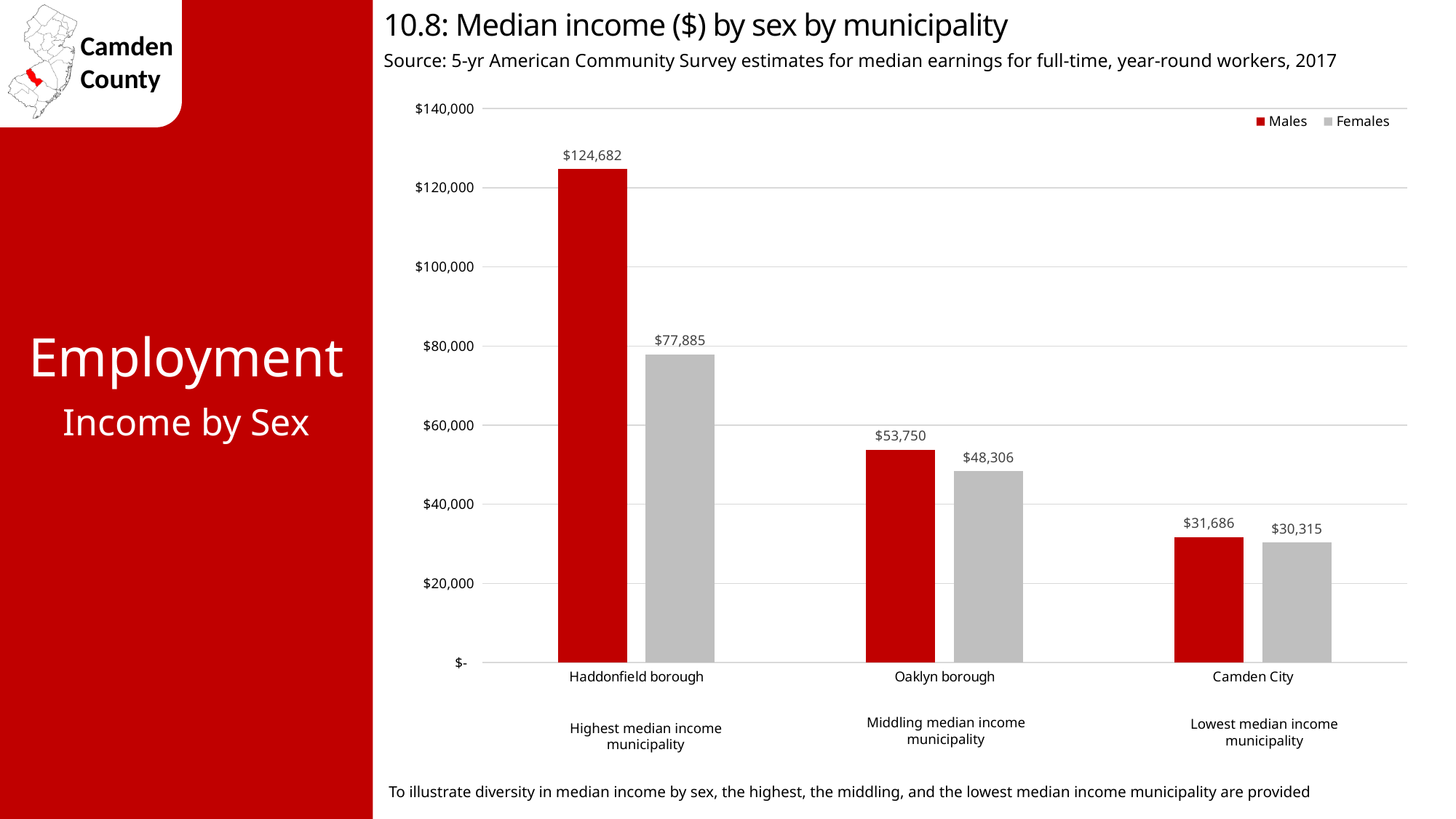
What kind of chart is shown on the slide? Bar chart What is the median income for females in Camden City? $30,315 Which municipality has the highest median income for males? Haddonfield borough What is the median income for males in Haddonfield borough? $124,682 What is the difference between male and female median income in Oaklyn borough? $5,444 Which is larger in Oaklyn borough, the male or the female median income? Males How many series does the legend list? 2 Is the median income for females in Haddonfield borough greater or less than $80,000? less Which municipality has the lowest median income for females? Camden City What is the median income for females in Oaklyn borough? $48,306 What is the difference between male and female median income in Haddonfield borough? $46,797 How many municipalities are shown on the chart? 3